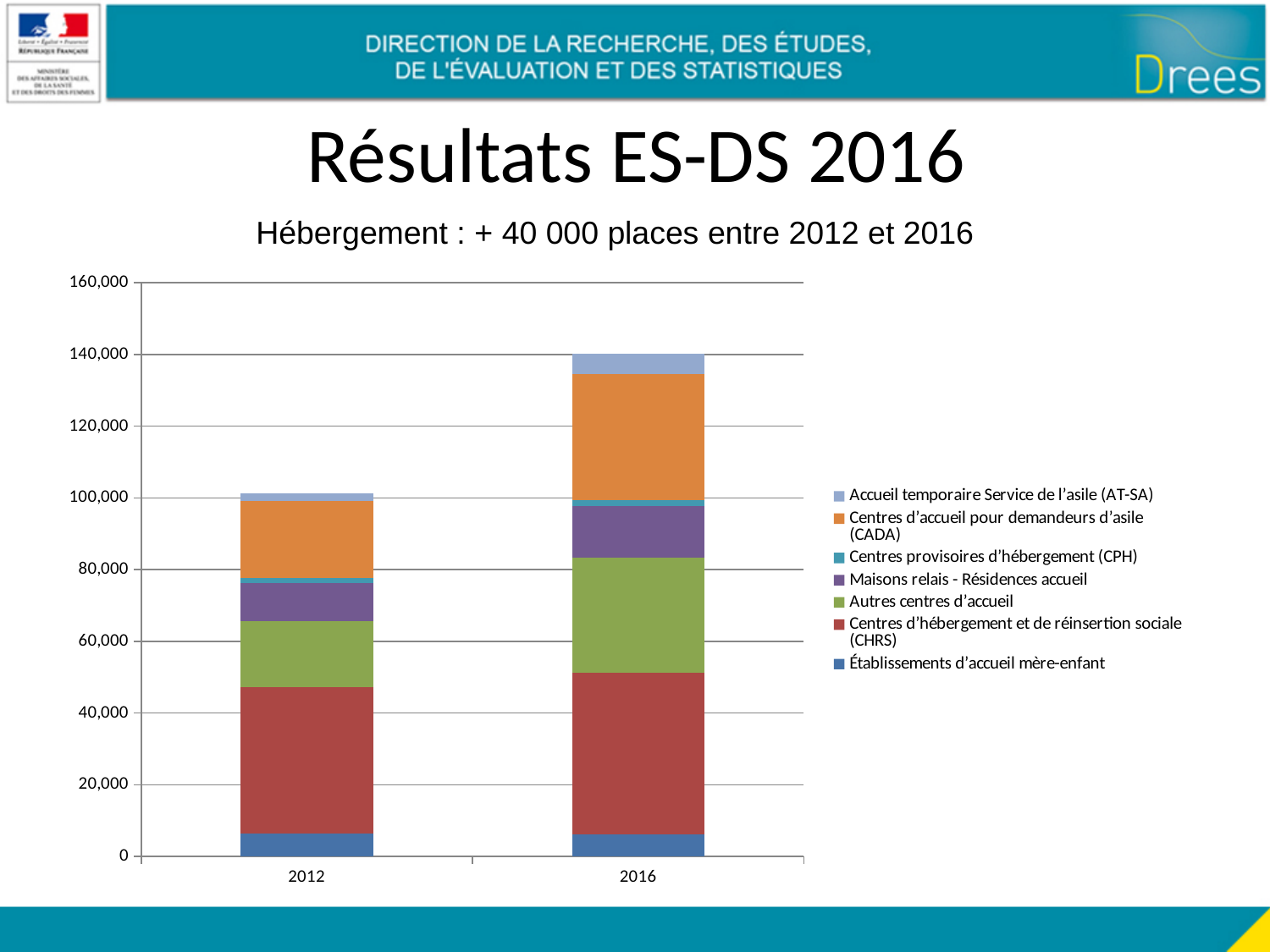
Is the 'Autres centres d'accueil' segment larger in 2012 or in 2016? 2016 Is the total for 2016 greater or less than 160,000? less Is the total for 2016 greater or less than 120,000? greater Which year has the taller stacked bar, 2012 or 2016? 2016 Which series is at the bottom of each stacked bar? Établissements d'accueil mère-enfant Is the total for 2012 greater or less than 120,000? less What kind of chart is shown on the slide? bar chart How many years (categories) are shown on the x axis of the chart? 2 What is the heading shown above the chart? Hébergement : + 40 000 places entre 2012 et 2016 How many series does the chart's legend list? 7 Does the total number of places rise or fall from 2012 to 2016? rise